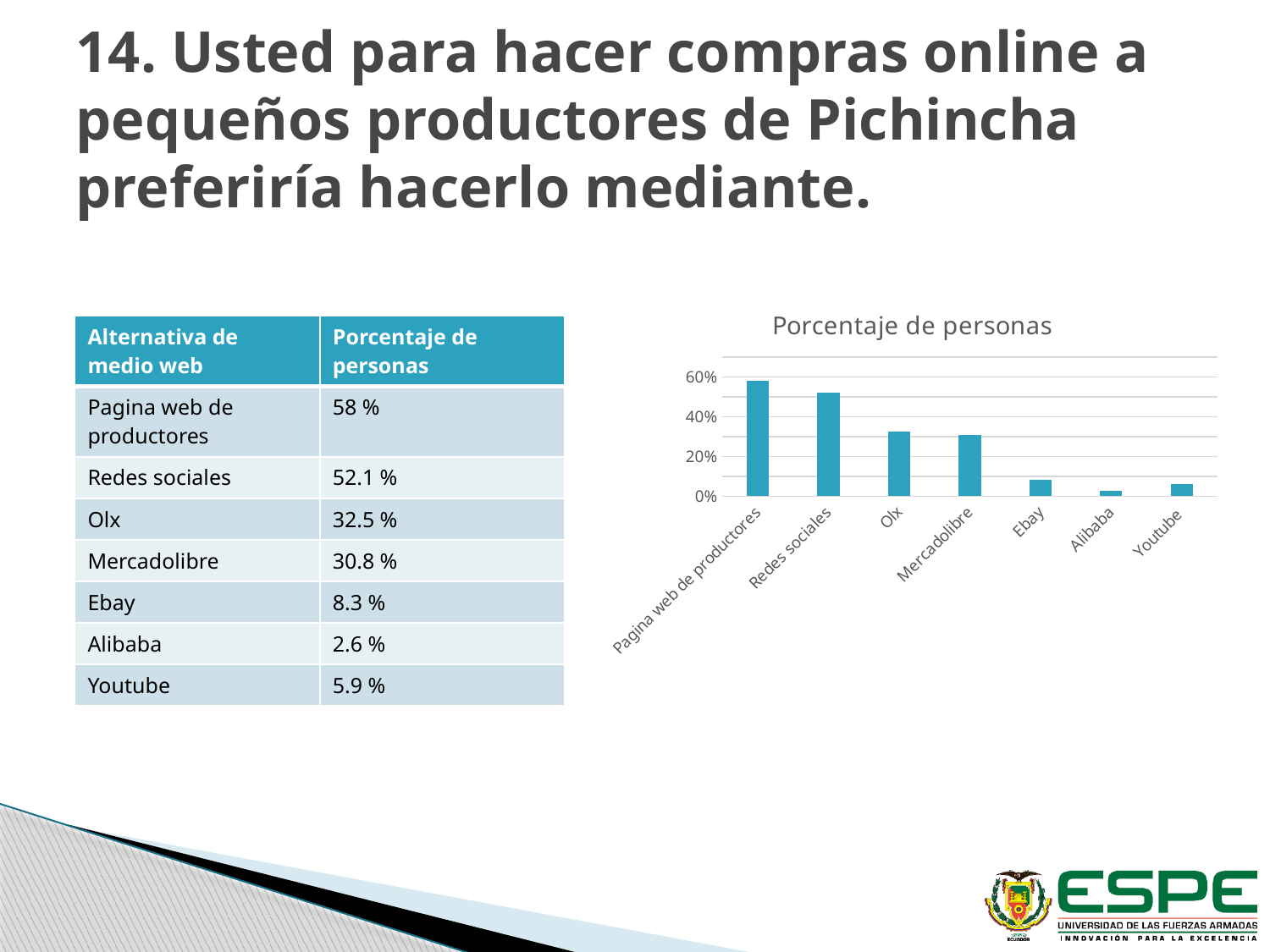
What is the value for Olx? 32.5 % Is the value for Redes sociales greater or less than 40%? greater What is the difference between the value for Pagina web de productores and the value for Redes sociales? 5.9 % How many categories are plotted in the chart? 7 Which is larger, the value for Pagina web de productores or the value for Redes sociales? Pagina web de productores Is the value for Mercadolibre greater or less than 40%? less What kind of chart is shown on the slide? bar chart Which is larger, the value for Youtube or the value for Alibaba? Youtube What is the value for Ebay? 8.3 % What is the title of the chart? Porcentaje de personas Which category has the lowest value in the chart? Alibaba Which category has the highest value in the chart? Pagina web de productores